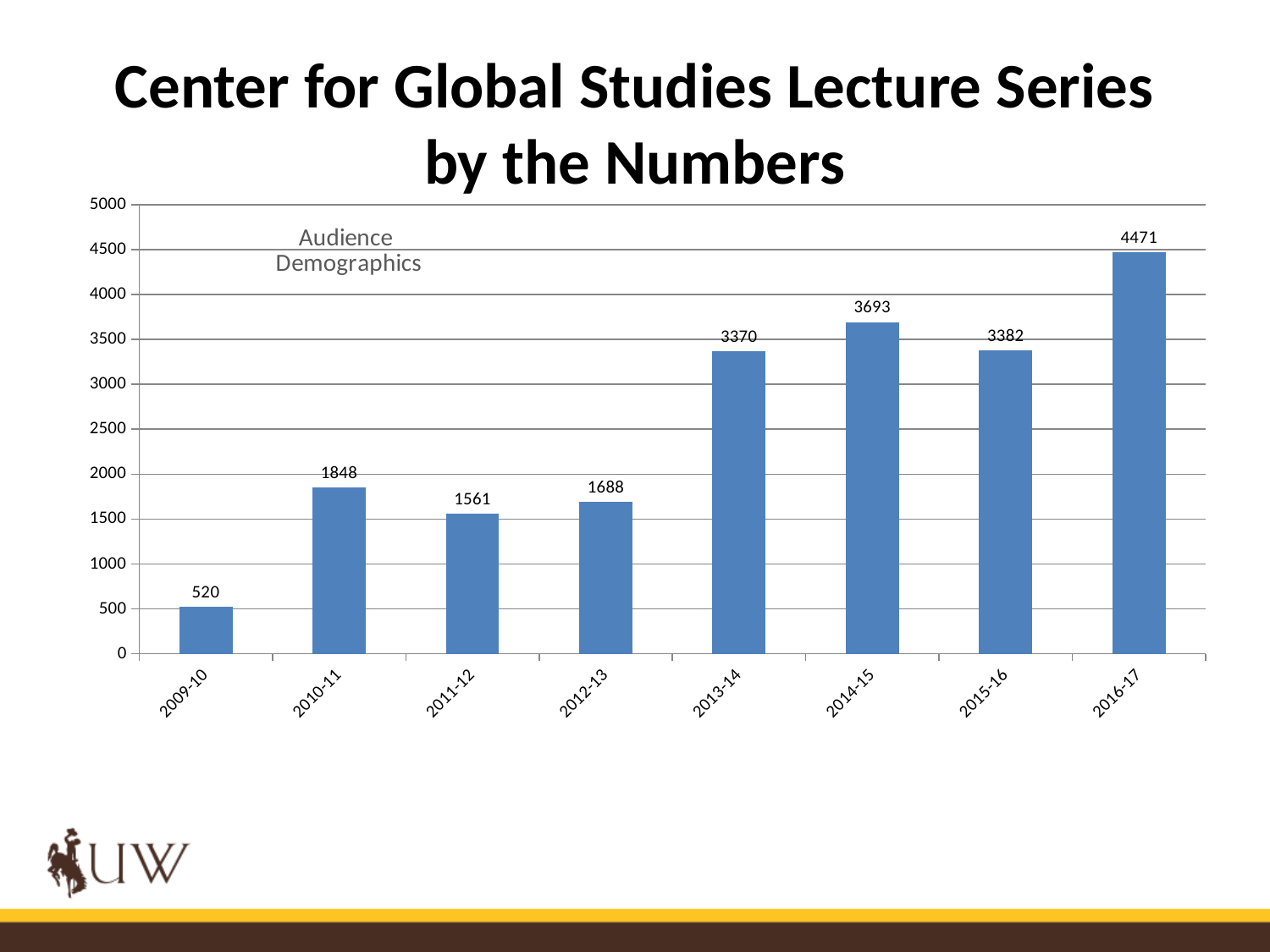
What kind of chart is shown on the slide? bar chart How many years are shown on the x axis? 8 Which year has the highest value? 2016-17 Is the value for 2013-14 greater or less than 3000? greater What is the value for 2014-15? 3693 What is the chart's title? Audience Demographics What is the difference between the values for 2010-11 and 2009-10? 1328 What is the value for 2011-12? 1561 What is the value for 2009-10? 520 Which year has the lowest value? 2009-10 What is the difference between the values for 2016-17 and 2015-16? 1089 Which is larger, the value for 2012-13 or the value for 2011-12? 2012-13